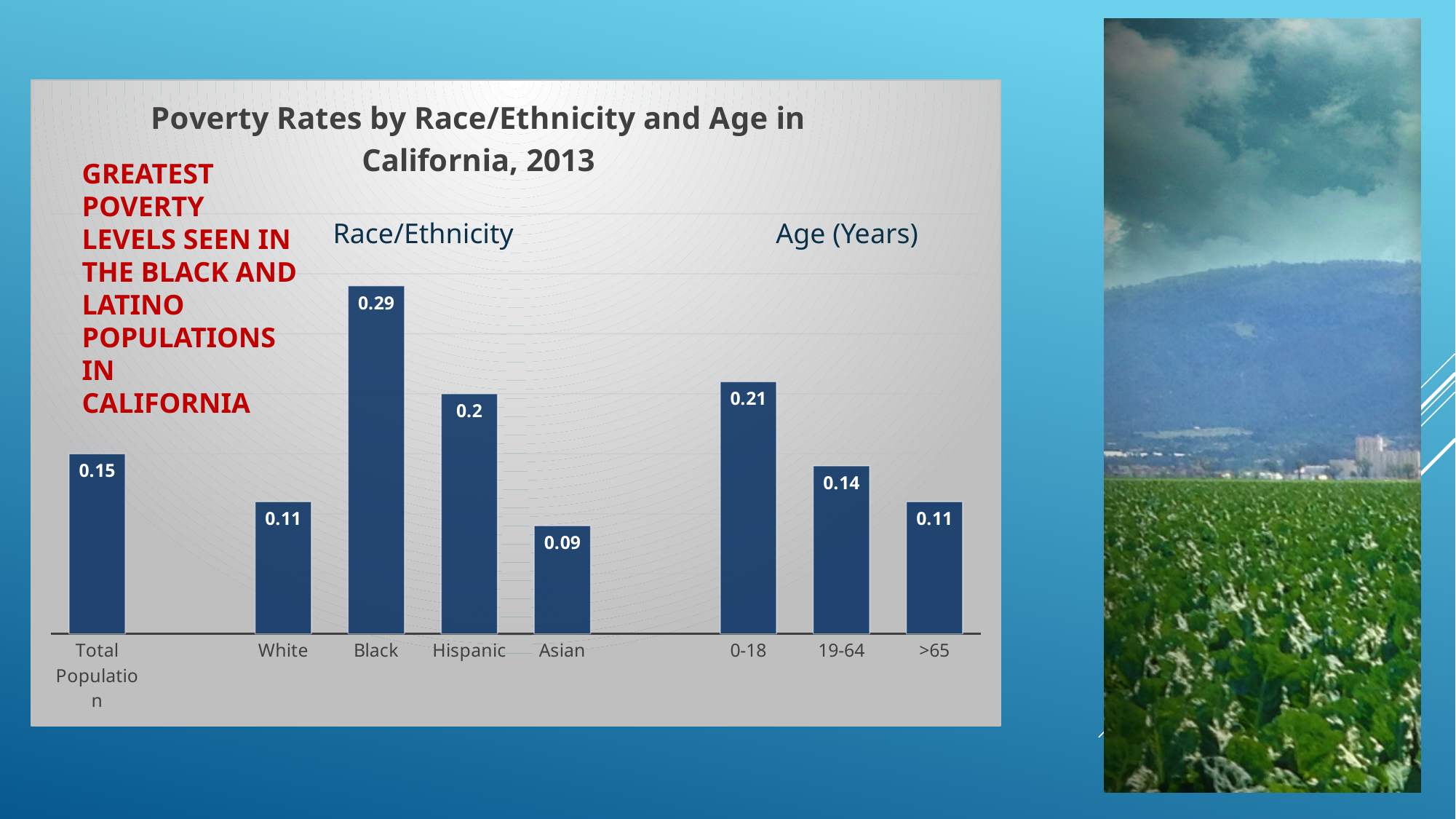
What is the difference between the poverty rates for the 0-18 and 19-64 age groups? 0.07 Which category has the highest poverty rate on the chart? Black What is the poverty rate shown for the Black category? 0.29 Which has a higher poverty rate, Hispanic or 0-18? 0-18 What is the difference between the poverty rates for Black and Hispanic? 0.09 How many bars are plotted on the chart? 8 What is the poverty rate shown for the 0-18 age group? 0.21 What is the title of the chart? Poverty Rates by Race/Ethnicity and Age in California, 2013 What is the poverty rate shown for the Total Population? 0.15 Which category has the lowest poverty rate on the chart? Asian What type of chart is shown on the slide? Bar chart What is the poverty rate shown for the Asian category? 0.09